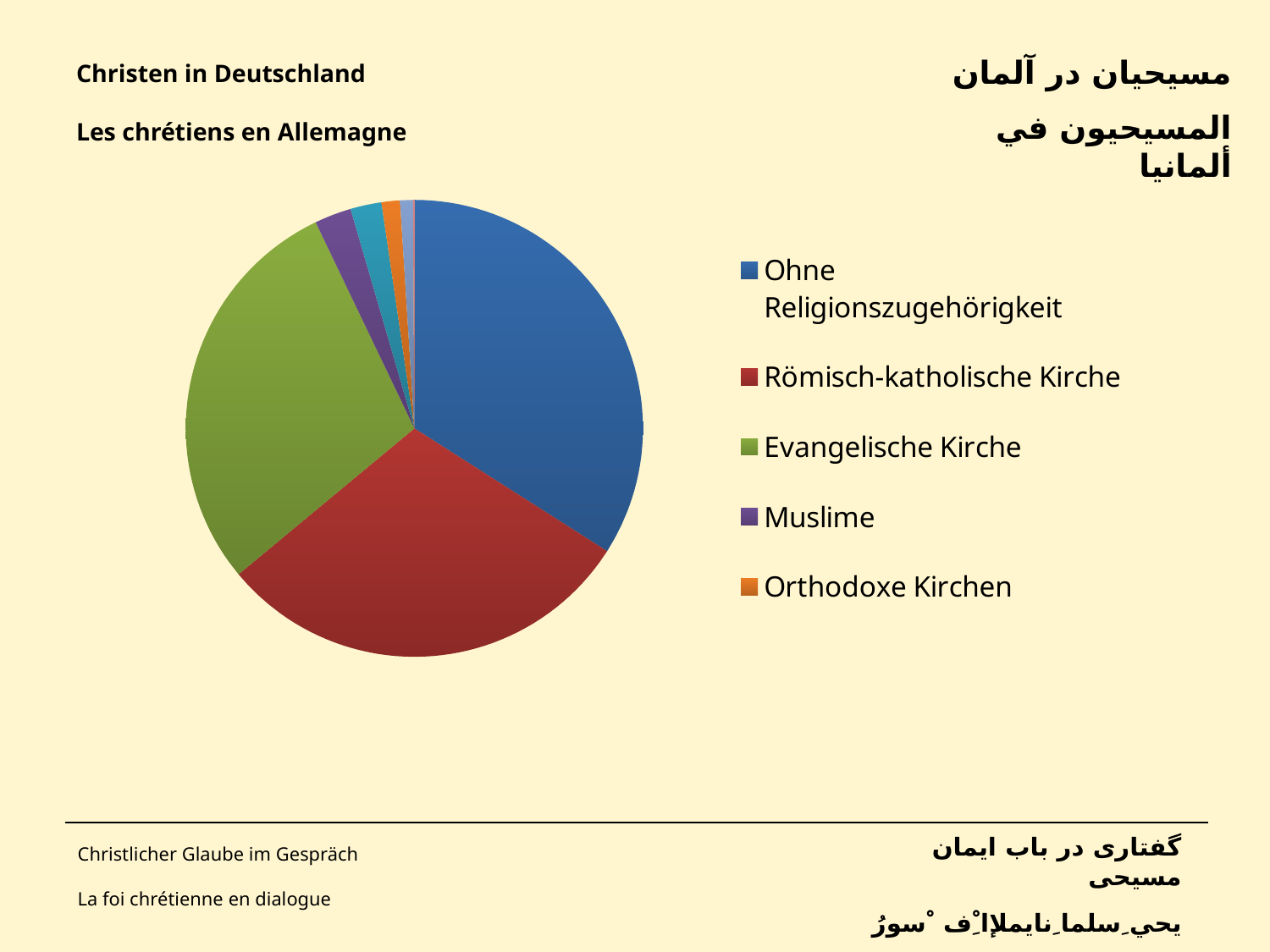
How many entries does the chart legend list? 5 What colour represents Evangelische Kirche in the pie chart? green Which slice is larger, Ohne Religionszugehörigkeit or Evangelische Kirche? Ohne Religionszugehörigkeit Which legend category has the largest slice of the pie? Ohne Religionszugehörigkeit Which slice is larger, Römisch-katholische Kirche or Orthodoxe Kirchen? Römisch-katholische Kirche Which slice is larger, Muslime or Orthodoxe Kirchen? Muslime What kind of chart is shown on the slide? pie chart What is the German title shown above the chart? Christen in Deutschland